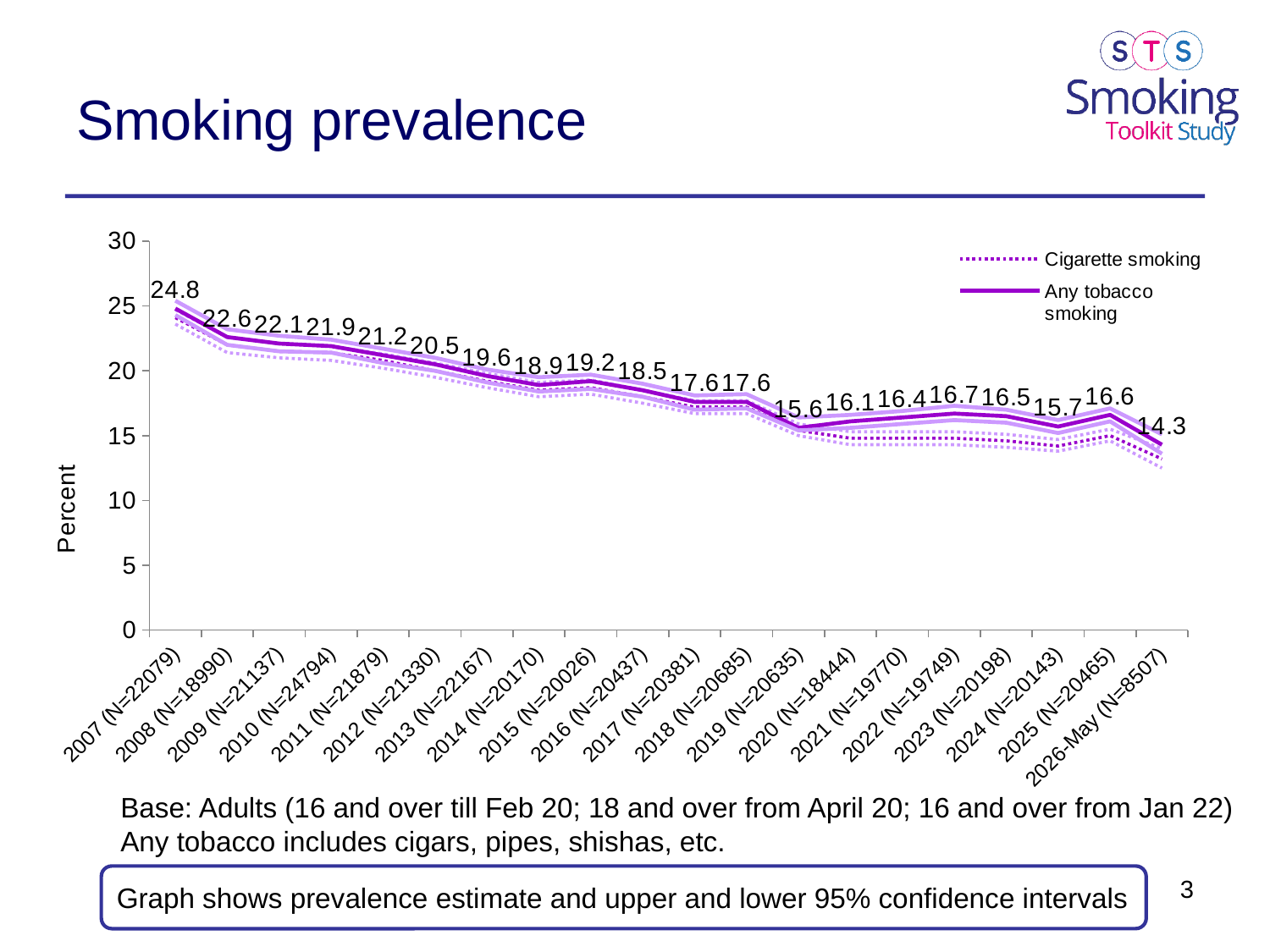
How many time points are plotted on the x axis? 20 What is the any tobacco smoking prevalence for 2007 (N=22079)? 24.8 What kind of chart is shown on the slide? Line chart Which year has the highest any tobacco smoking prevalence? 2007 (N=22079) Is the cigarette smoking prevalence for 2026-May (N=8507) greater or less than 15? less Which year has the lowest any tobacco smoking prevalence? 2026-May (N=8507) What is the any tobacco smoking prevalence for 2026-May (N=8507)? 14.3 What is the difference in any tobacco smoking prevalence between 2007 (N=22079) and 2026-May (N=8507)? 10.5 Which is larger, the any tobacco smoking prevalence in 2015 (N=20026) or in 2016 (N=20437)? 2015 (N=20026) How many series does the legend list? 2 Does the any tobacco smoking prevalence generally rise or fall from 2007 to 2026-May? Fall What is the any tobacco smoking prevalence for 2019 (N=20635)? 15.6